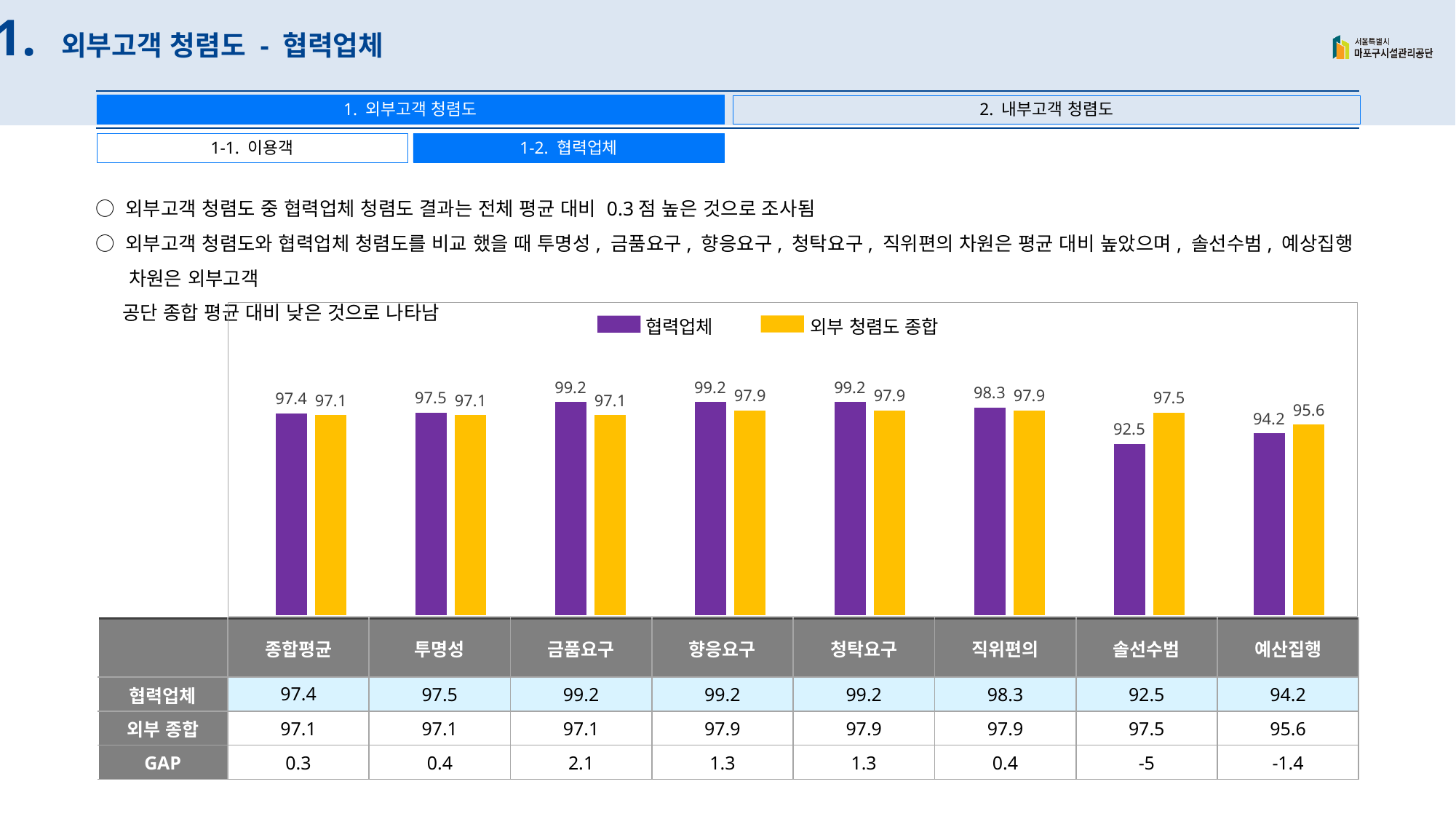
Which category has the lowest value for the 외부 청렴도 종합 series? 예산집행 What is the difference between the 협력업체 and 외부 청렴도 종합 values in the 금품요구 category? 2.1 Which colour represents the 협력업체 series in the chart? purple In the 솔선수범 category, which series has the larger value, 협력업체 or 외부 청렴도 종합? 외부 청렴도 종합 What kind of chart is shown on the slide? bar chart What is the value for 협력업체 in the 금품요구 category? 99.2 What is the value for 협력업체 in the 예산집행 category? 94.2 In the 직위편의 category, which series has the larger value, 협력업체 or 외부 청렴도 종합? 협력업체 What is the value for 외부 청렴도 종합 in the 솔선수범 category? 97.5 Which category has the lowest value for the 협력업체 series? 솔선수범 How many categories are shown on the x axis of the chart? 8 How many series does the chart legend list? 2